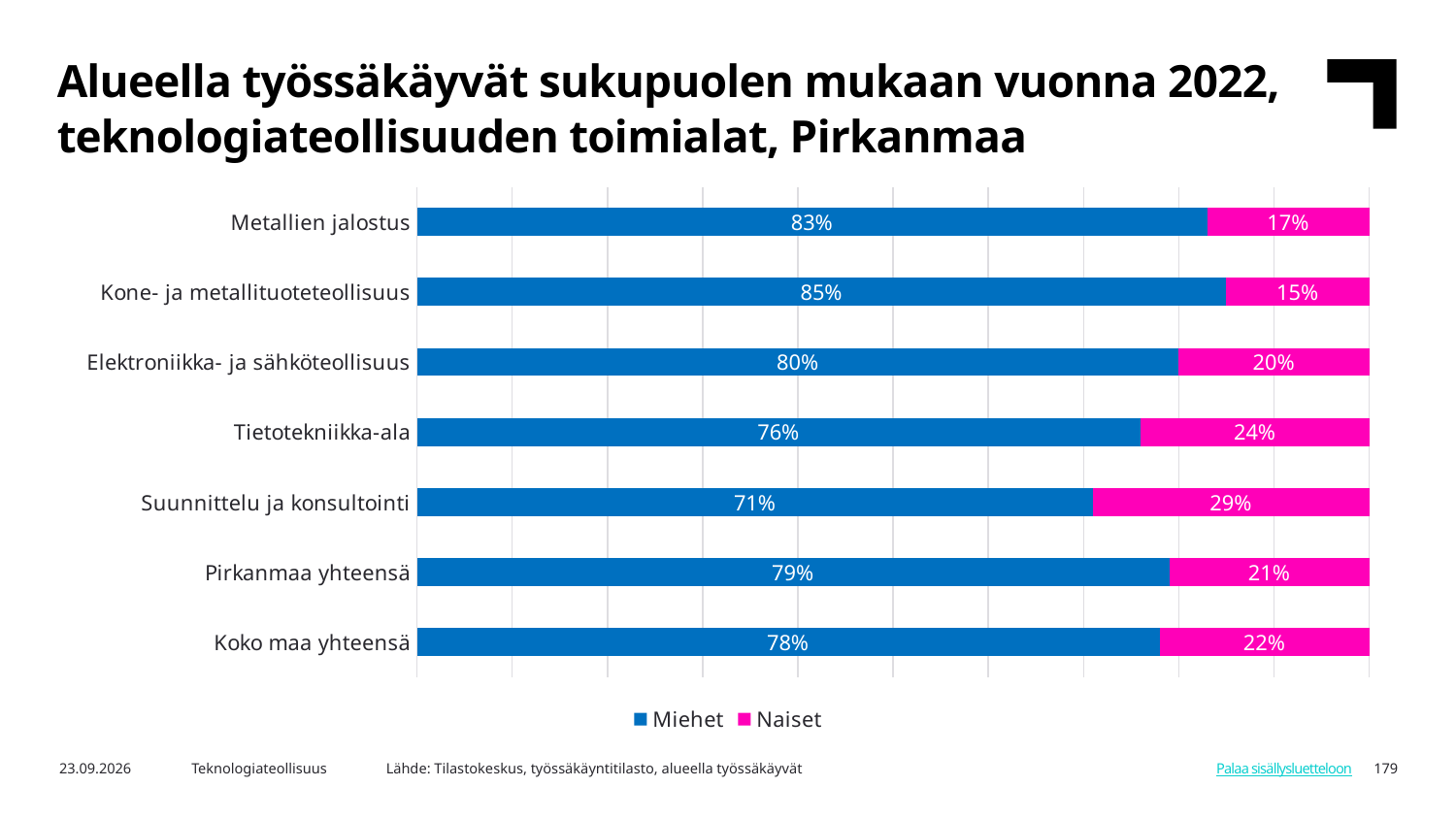
What is the total of the stacked bar for Elektroniikka- ja sähköteollisuus? 100% Which category has the lowest Naiset share? Kone- ja metallituoteteollisuus Which series is shown in pink? Naiset What is the Naiset share for Koko maa yhteensä? 22% What is the Miehet share for Metallien jalostus? 83% What is the difference between the Naiset share for Tietotekniikka-ala and for Metallien jalostus? 7 percentage points What is the Naiset share for Suunnittelu ja konsultointi? 29% What kind of chart is shown on the slide? Stacked bar chart How many series does the legend list? 2 How many categories are shown on the chart? 7 Which category has the highest Miehet share? Kone- ja metallituoteteollisuus Which is larger: the Miehet share for Pirkanmaa yhteensä or for Koko maa yhteensä? Pirkanmaa yhteensä